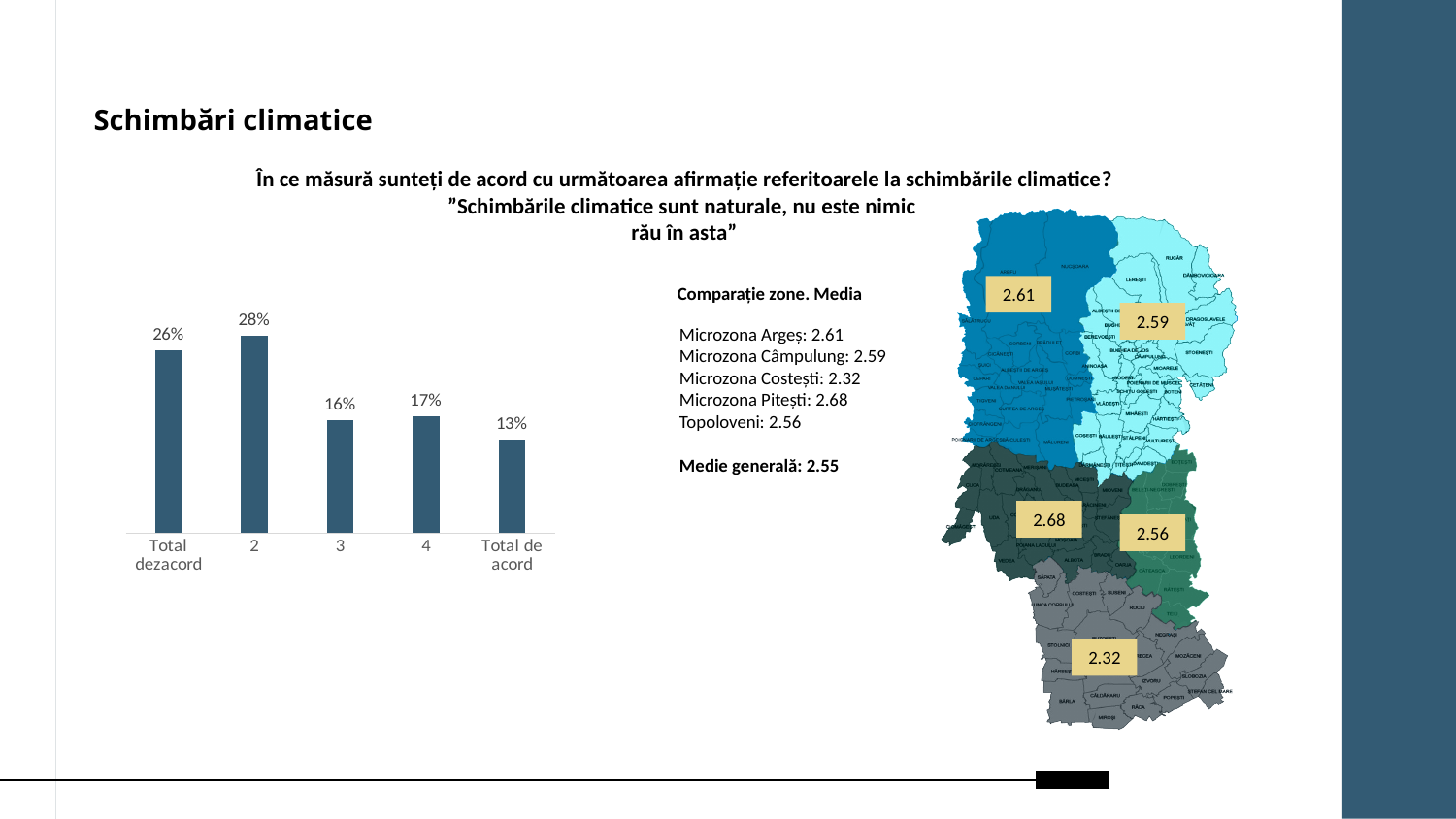
Which category has the lowest value in the bar chart? Total de acord What is the value shown for category "2"? 28% What is the difference between the values for "2" and "Total de acord"? 15% Which is larger, the value for "Total dezacord" or the value for "4"? Total dezacord How many categories are shown on the x axis of the bar chart? 5 What kind of chart is used to show the response distribution? Bar chart What is the difference between the values for "Total dezacord" and "3"? 10% What is the value for category "3"? 16% What is the combined value of "Total dezacord" and "2"? 54% What percentage is shown for "Total de acord"? 13% What percentage of respondents chose "Total dezacord"? 26% Which category has the highest value in the bar chart? 2